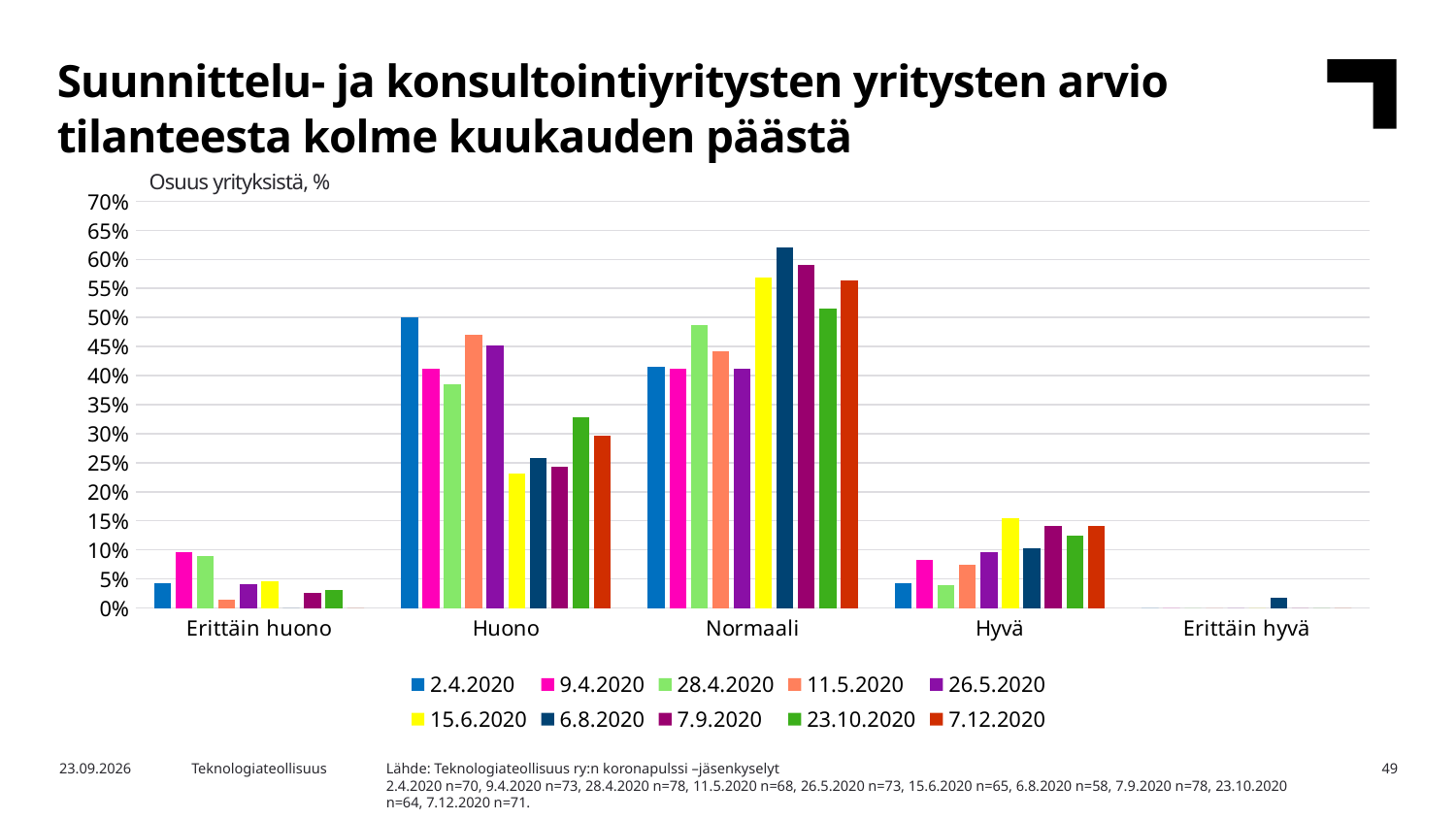
How many categories are shown on the x axis? 5 In the Huono category, which is larger: the 2.4.2020 bar or the 15.6.2020 bar? 2.4.2020 Is the value for Normaali in the 6.8.2020 series greater or less than 55%? greater What is the label shown above the y axis? Osuus yrityksistä, % Is the value for Hyvä in the 15.6.2020 series greater or less than 10%? greater Is the value for Erittäin huono in the 9.4.2020 series greater or less than 5%? greater In the Normaali category, which series has the highest bar? 6.8.2020 For the 2.4.2020 series, which category has the highest bar? Huono For the 6.8.2020 series, which category has the highest bar? Normaali How many series does the legend list? 10 What kind of chart is shown on the slide? bar chart